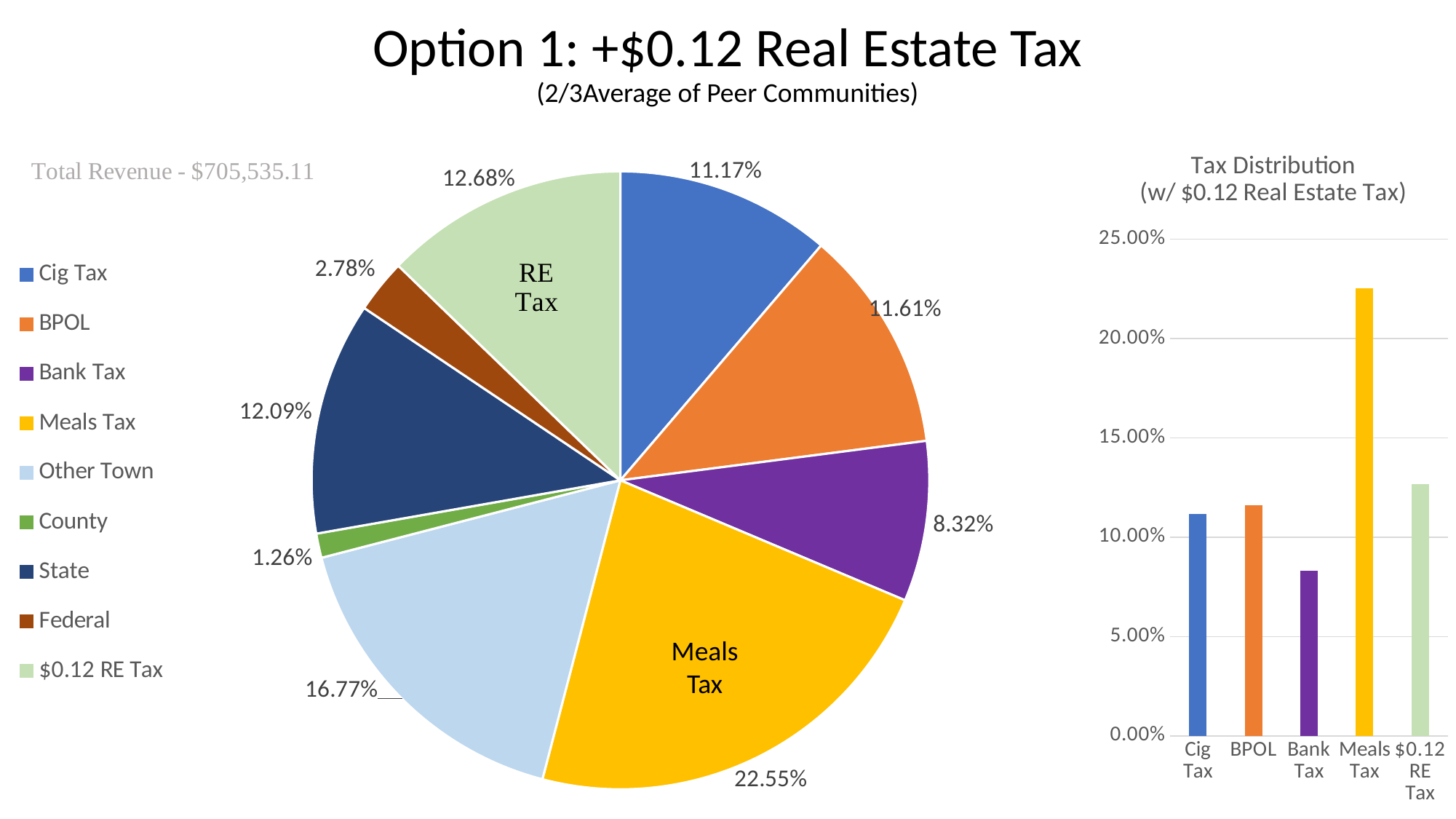
How many categories does the pie chart's legend list? 9 On the Tax Distribution bar chart, is the value for Bank Tax greater or less than 10.00%? less On the Tax Distribution bar chart, is the value for Meals Tax greater or less than 20.00%? greater On the pie chart, what share does $0.12 RE Tax have? 12.68% On the pie chart, what is the difference between the Meals Tax share and the Other Town share? 5.78% On the pie chart, which category has the smallest share? County What kind of chart is the Tax Distribution chart on the right? Bar chart On the pie chart, what share does County have? 1.26% On the pie chart, what share does Other Town have? 16.77% On the pie chart, which is larger, the State share or the BPOL share? State On the pie chart, what share does Meals Tax have? 22.55% On the pie chart, which category has the largest share? Meals Tax